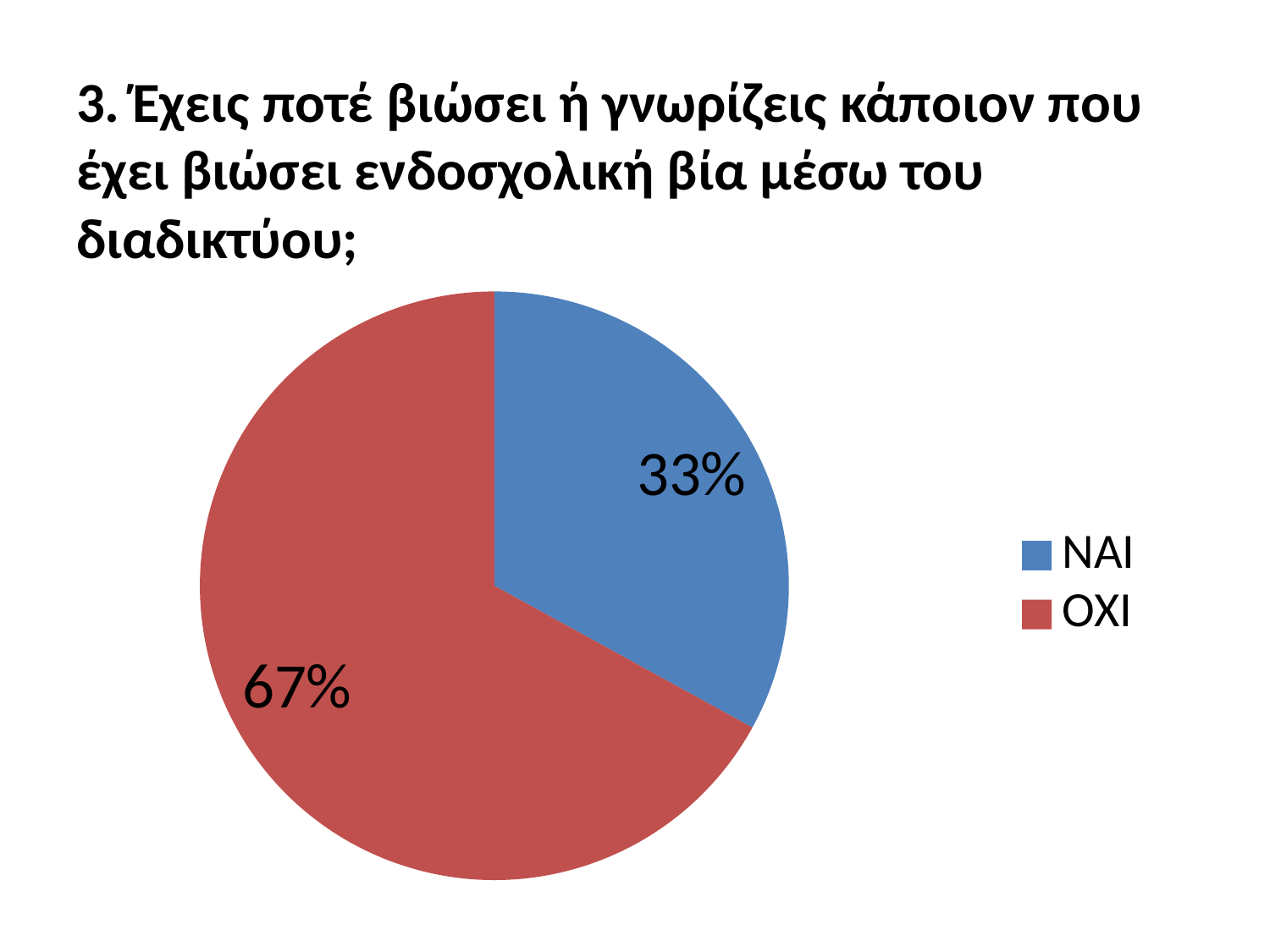
What is the difference in percentage points between the ΟΧΙ and ΝΑΙ slices? 34 How many slices does the pie chart have? 2 Which category has the smallest share of the pie? ΝΑΙ What colour is the ΟΧΙ slice? red What colour is the ΝΑΙ slice? blue What percentage of the pie is labelled ΟΧΙ? 67% What percentage of the pie is labelled ΝΑΙ? 33% How many entries does the legend list? 2 What kind of chart is shown on the slide? pie chart Which is larger, the ΝΑΙ slice or the ΟΧΙ slice? ΟΧΙ Which category has the largest share of the pie? ΟΧΙ What share of the pie does the ΝΑΙ slice represent? 33%